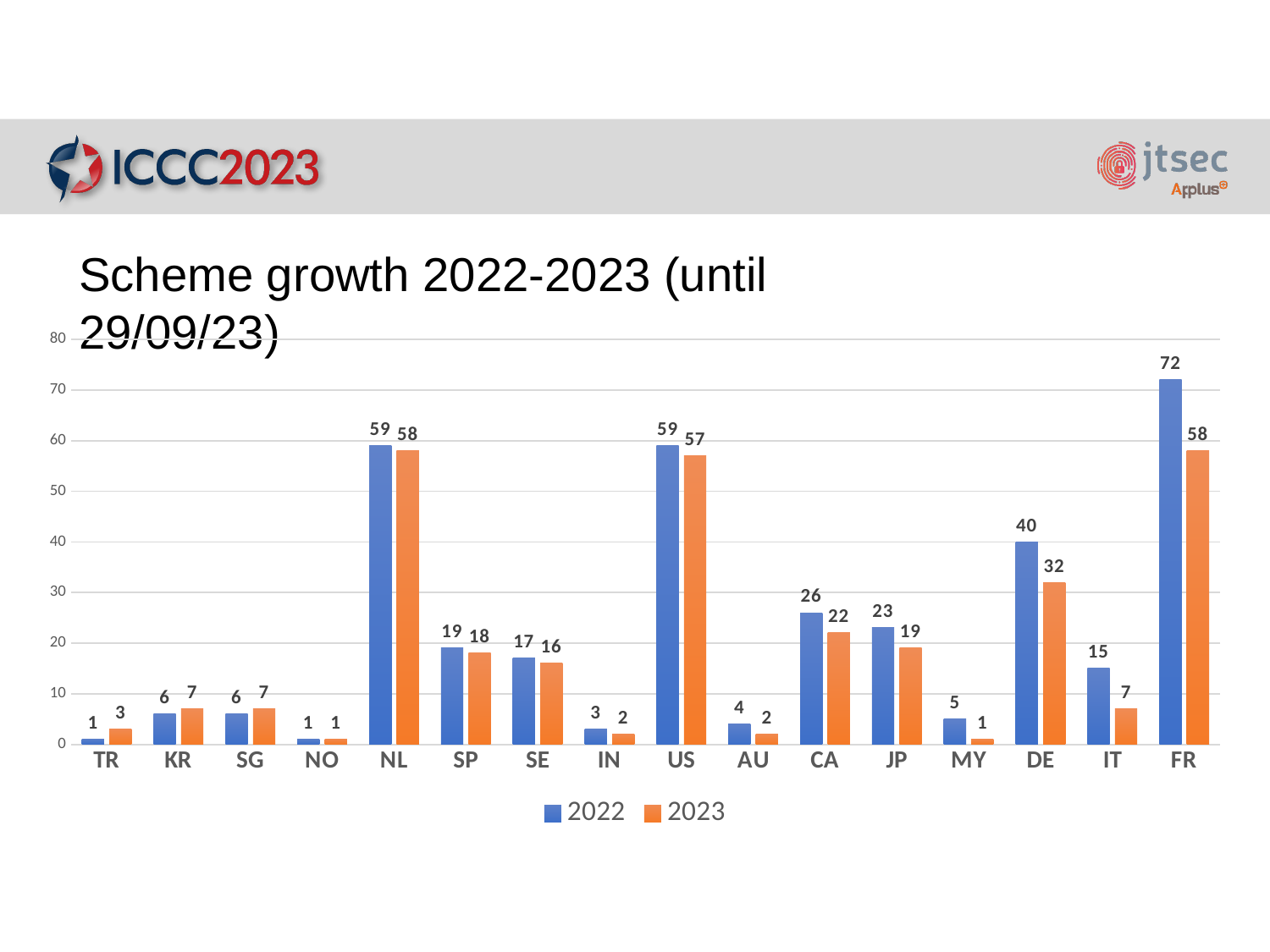
What is the difference between the 2022 and 2023 values for DE? 8 What is the 2022 value for CA? 26 Which category has the highest 2022 value? FR What kind of chart is shown on the slide? bar chart Is the 2022 value for FR greater or less than 70? greater How many categories are shown on the x axis? 16 What is the title of the chart? Scheme growth 2022-2023 (until 29/09/23) Which category has the lowest 2023 value? NO and MY (both 1) How many series does the legend list? 2 What is the 2022 value for FR? 72 What is the 2023 value for DE? 32 Which is larger, the 2023 value for NL or the 2023 value for US? NL